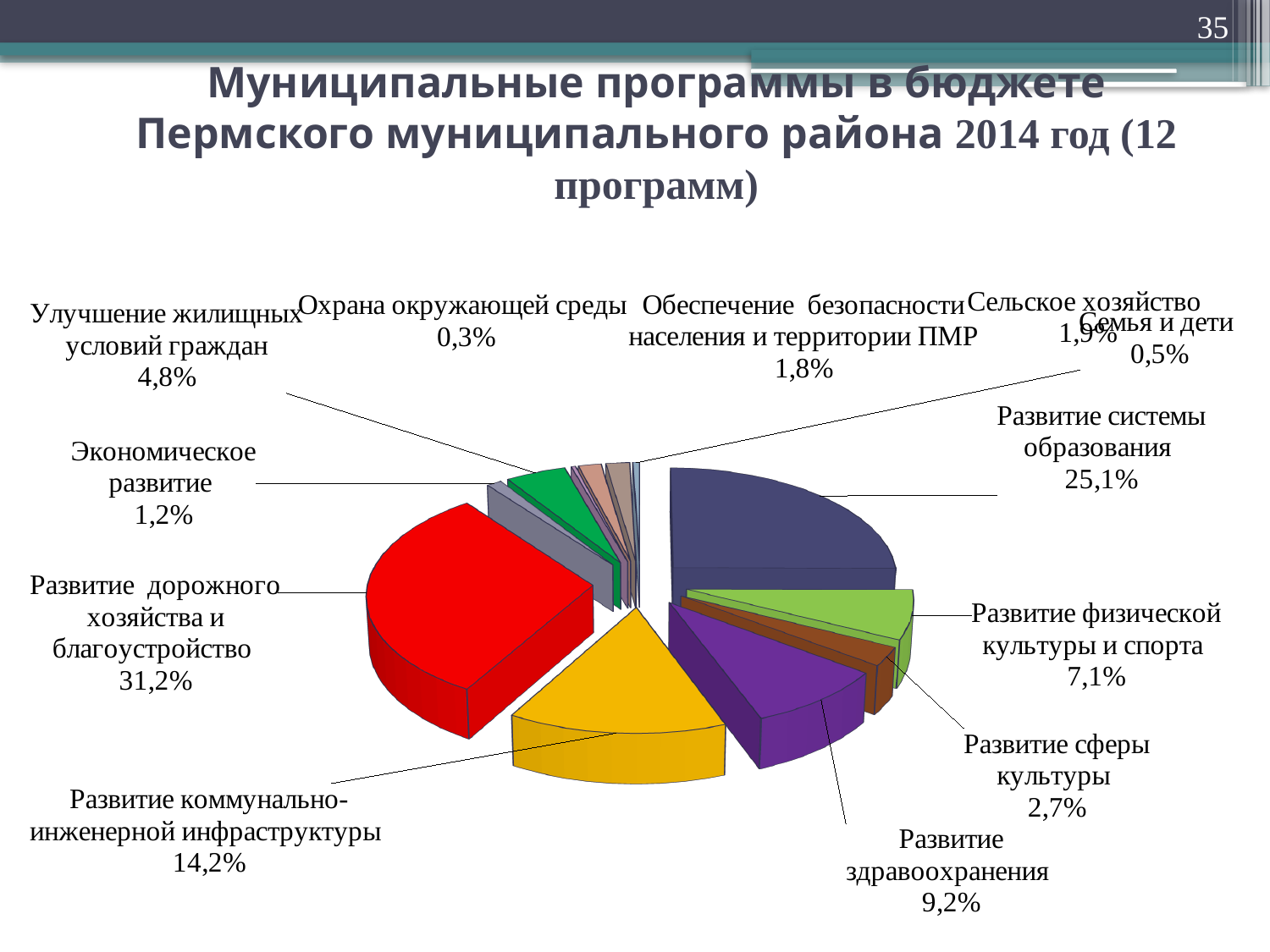
What share is shown for Развитие коммунально-инженерной инфраструктуры? 14,2% What share of the budget goes to Развитие дорожного хозяйства и благоустройство? 31,2% What is the combined share of Развитие сферы культуры and Экономическое развитие? 3,9% What kind of chart is shown on the slide? pie chart What share is shown for Охрана окружающей среды? 0,3% Which is larger: the share for Развитие физической культуры и спорта or the share for Развитие здравоохранения? Развитие здравоохранения What share is shown for Развитие здравоохранения? 9,2% What is the difference between the shares of Развитие дорожного хозяйства и благоустройство and Развитие системы образования? 6,1% Which program has the smallest share of the pie? Охрана окружающей среды What share is shown for Развитие системы образования? 25,1% Which program has the largest share of the pie? Развитие дорожного хозяйства и благоустройство How many programs (slices) are shown in the pie chart? 12